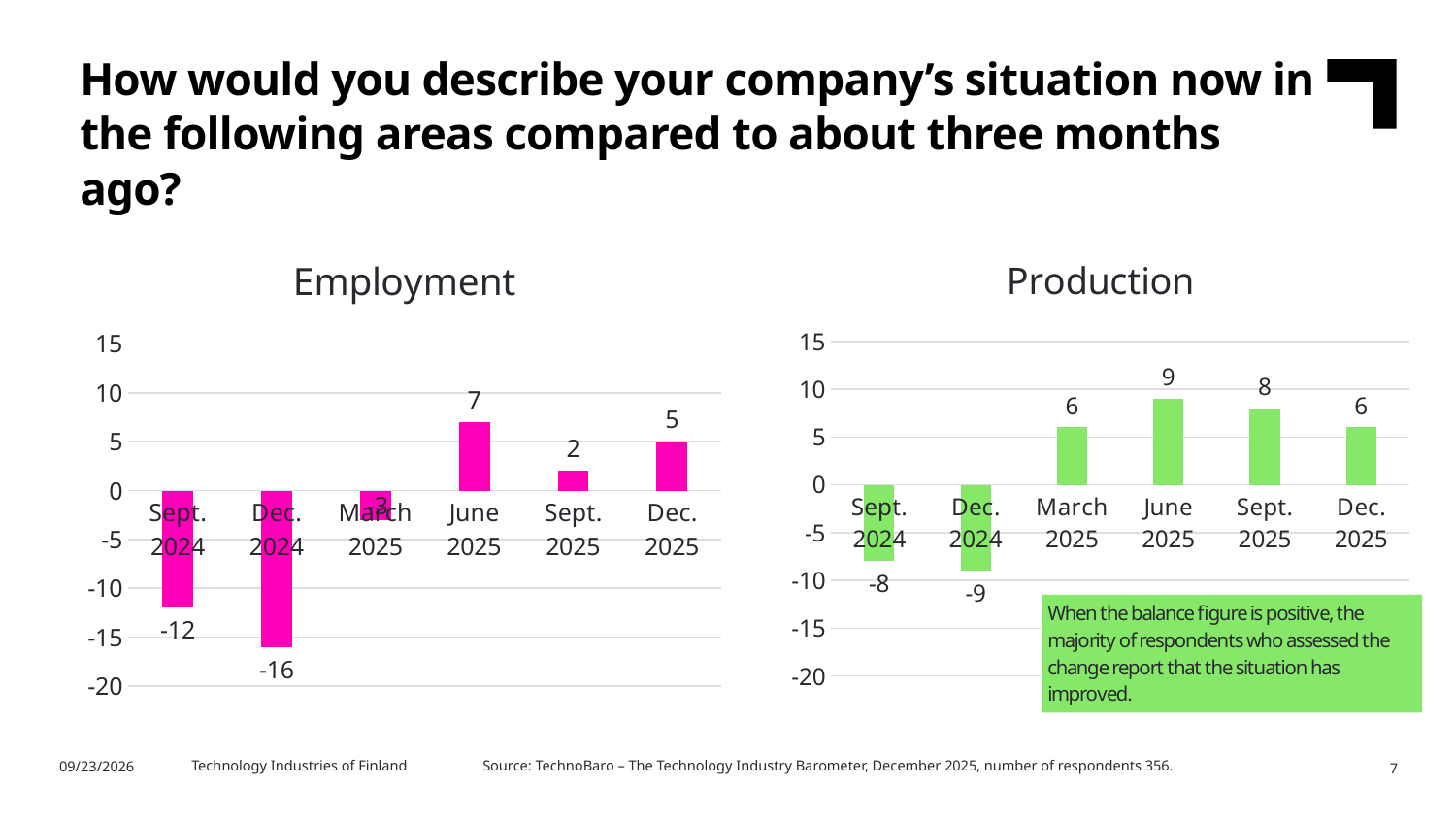
How many periods are shown on the x axis of the Employment chart? 6 In the Production chart, what is the difference between the values for June 2025 and Dec. 2025? 3 In the Production chart, what is the value for June 2025? 9 In the Production chart, which period has the highest value? June 2025 What kind of chart is the Production chart? Bar chart In the Employment chart, what is the value for June 2025? 7 In the Employment chart, which period has the lowest value? Dec. 2024 In the Employment chart, is the value for Sept. 2024 greater or less than -10? less In the Employment chart, what is the value for Dec. 2024? -16 In the Production chart, what is the value for Dec. 2024? -9 In the Production chart, which is larger, the value for Sept. 2025 or the value for Dec. 2025? Sept. 2025 In the Employment chart, what is the difference between the values for June 2025 and Sept. 2025? 5